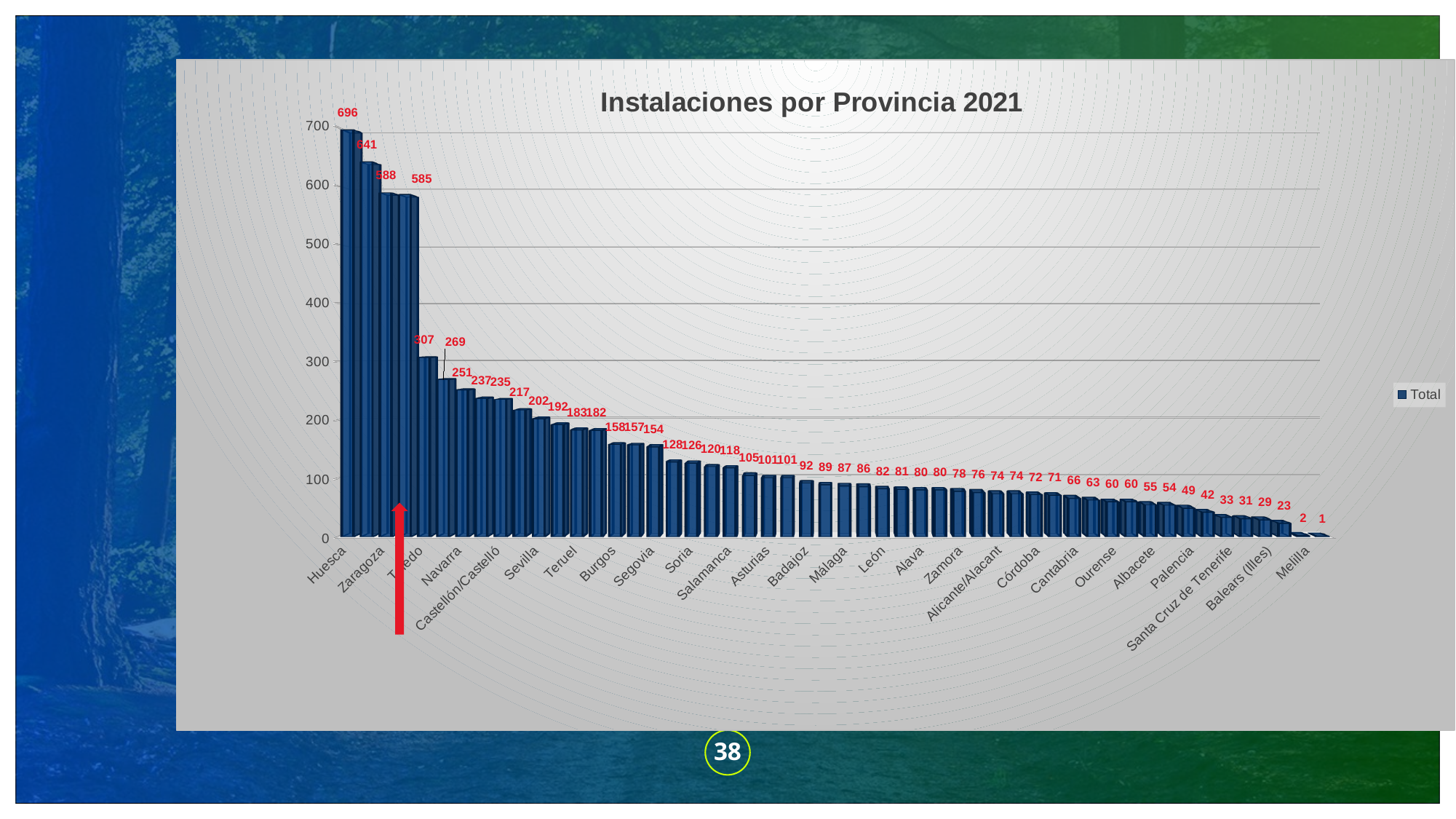
Do the values rise or fall moving from left to right along the x axis? fall What is the title of the chart? Instalaciones por Provincia 2021 Which is larger, the value for Huesca or the value for Zaragoza? Huesca What type of chart is shown on the slide? bar chart What is the lowest value printed on the chart? 1 What is the name of the series shown in the legend? Total What is the value for Huesca? 696 Which province has the highest value in the chart? Huesca How many series does the legend list? 1 What is the difference between the two highest values, 696 and 641? 55 Is the value for Toledo greater or less than 400? less Is the value for Huesca greater or less than 600? greater